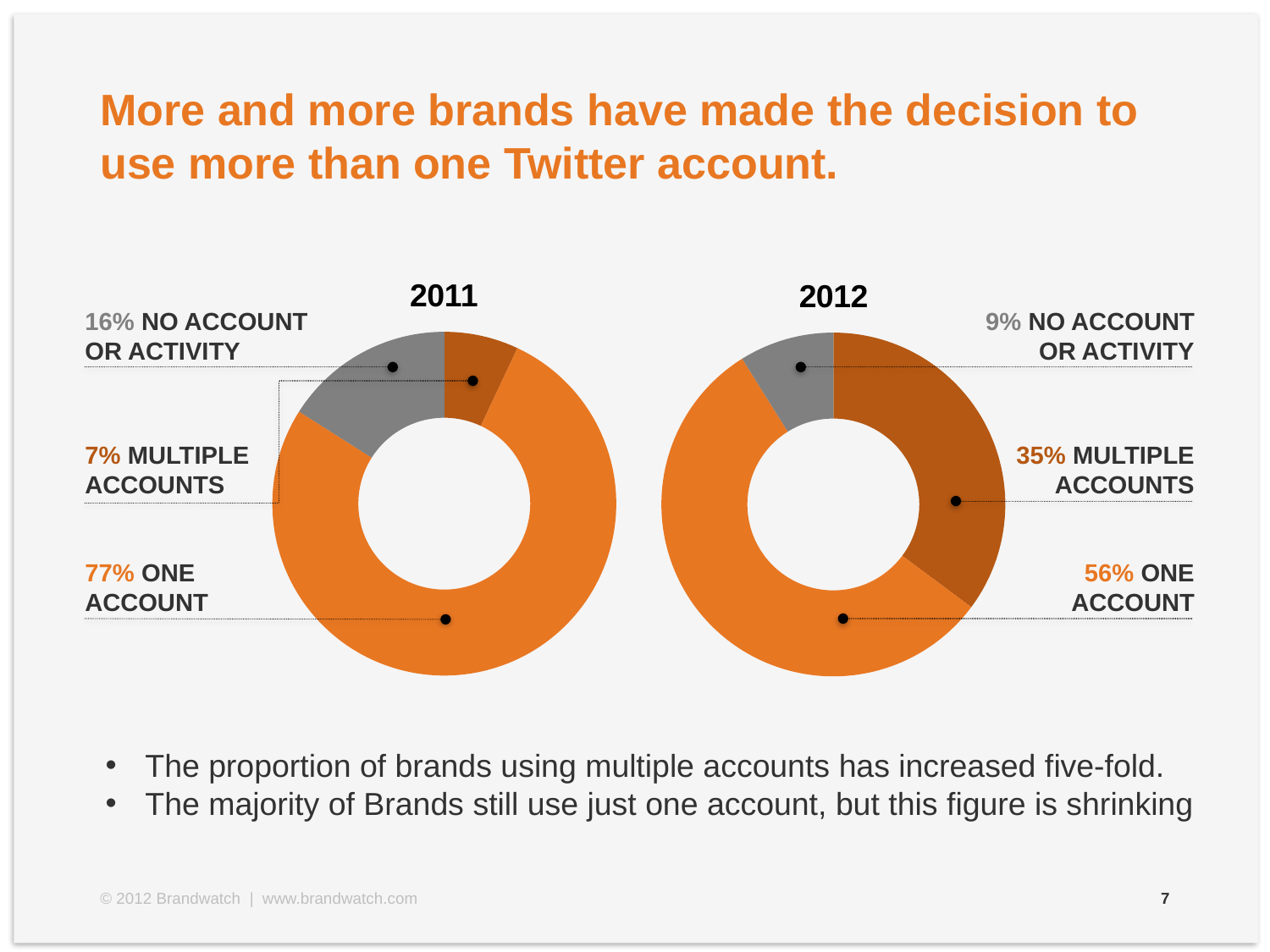
In the 2012 chart, what is the difference between the one account share and the multiple accounts share? 21% In the 2012 chart, what percentage of brands had multiple accounts? 35% In the 2011 chart, which category has the smallest share? Multiple accounts In the 2011 chart, what percentage of brands had one account? 77% What type of chart is used for the 2011 data? Doughnut chart What colour is the no account or activity segment in both charts? Grey In the 2012 chart, which category has the largest share? One account How many categories does the 2012 chart show? 3 Which is larger: the one account share in 2011 or the one account share in 2012? 2011 In the 2011 chart, what percentage of brands had no account or activity? 16% What is the difference between the multiple accounts share in 2012 and in 2011? 28% In the 2012 chart, what percentage of brands had no account or activity? 9%